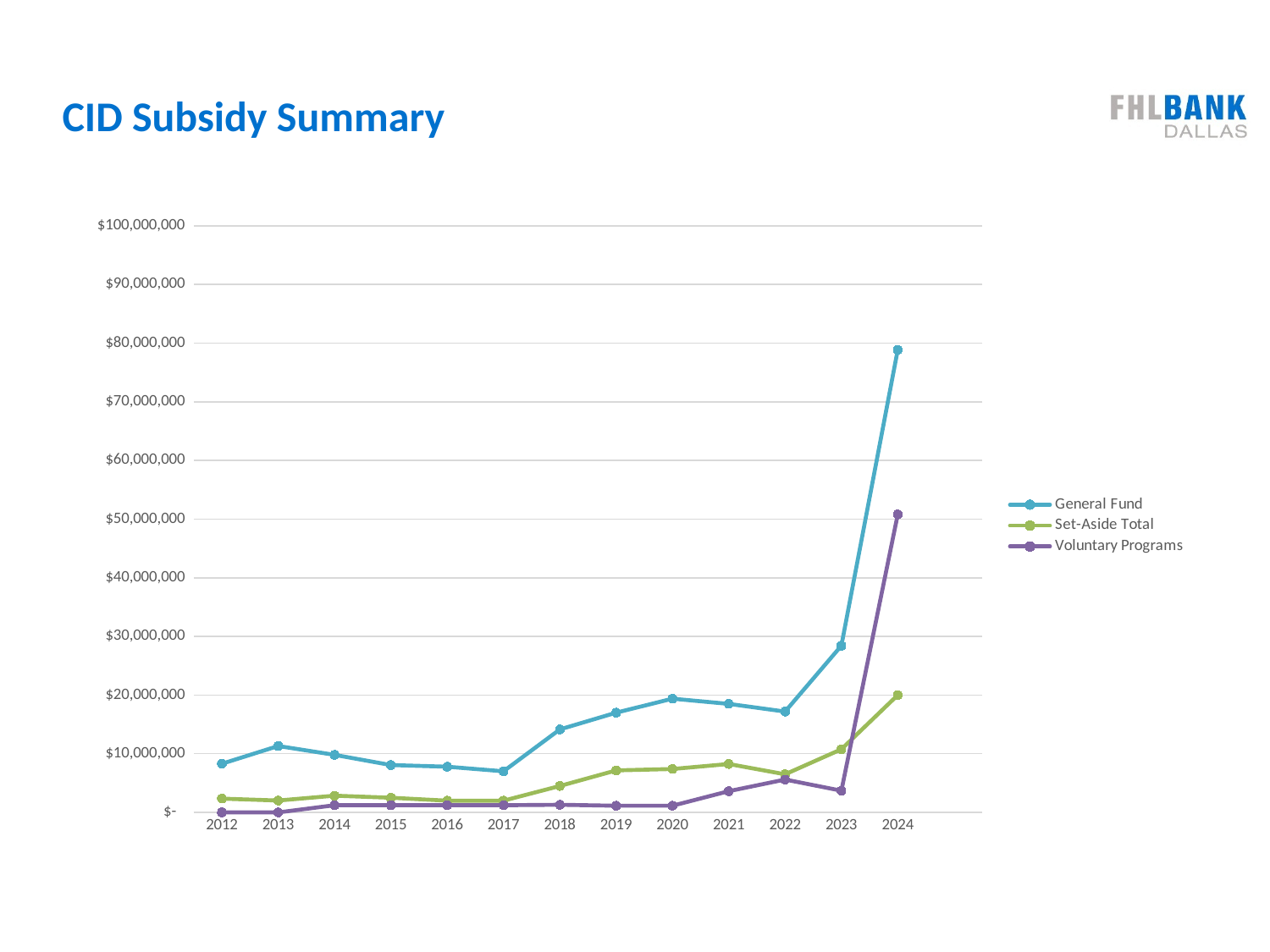
In 2023, which is larger: Set-Aside Total or Voluntary Programs? Set-Aside Total Is the General Fund value for 2024 greater or less than $70,000,000? greater How many years are plotted along the x axis? 13 In which year does the General Fund series reach its highest value? 2024 Which series is shown in purple in the legend? Voluntary Programs Is the General Fund value for 2023 greater or less than $30,000,000? less How many series does the legend list? 3 Is the Voluntary Programs value for 2024 greater or less than $40,000,000? greater In which year is the General Fund series at its lowest value? 2017 What is the title of the chart? CID Subsidy Summary Does the General Fund series rise or fall from 2022 to 2024? rise What kind of chart is shown on the slide? line chart